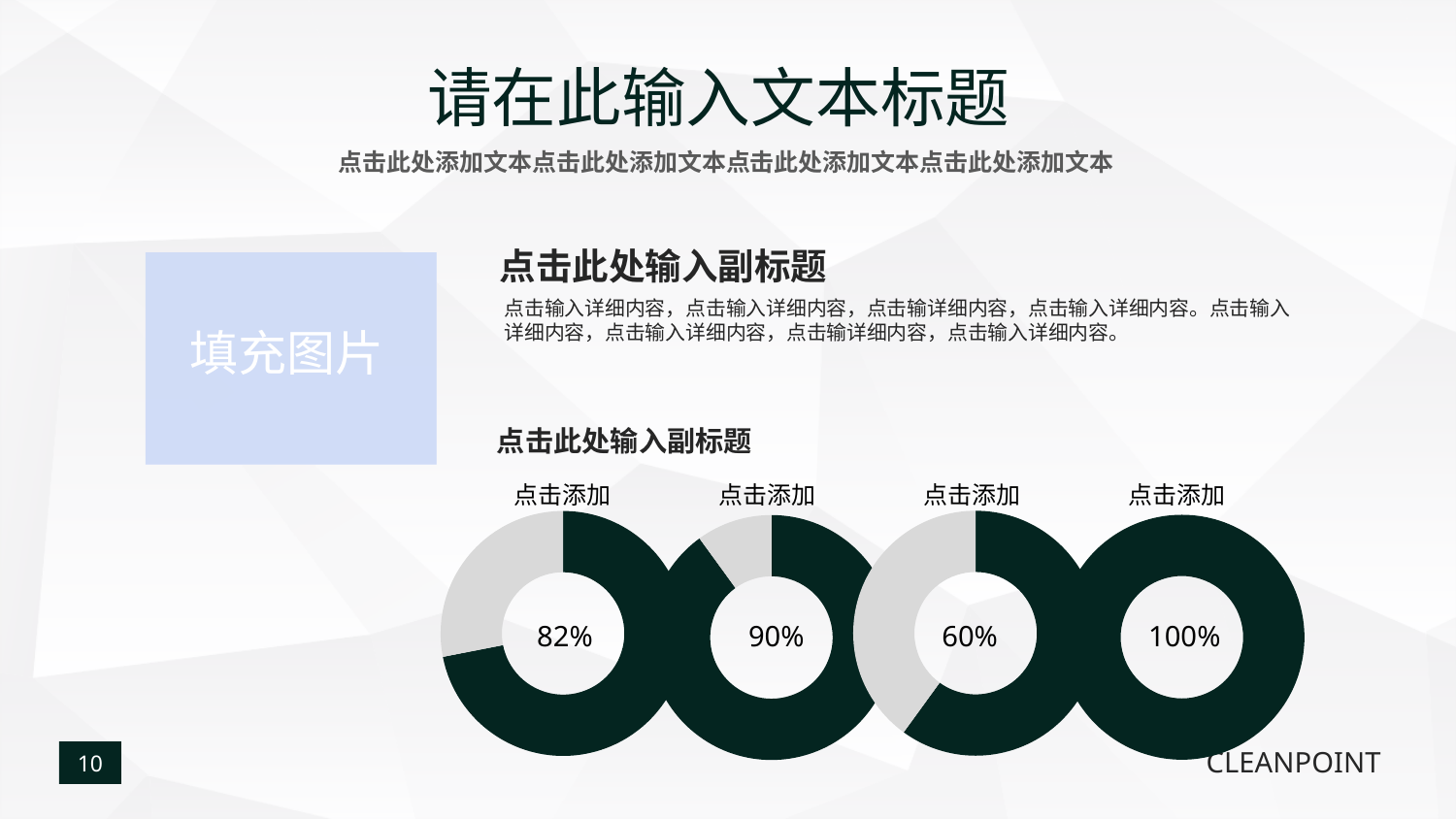
How many doughnut charts are shown on the slide? 4 What value is shown in the centre of the leftmost doughnut chart? 82% What label appears above each of the four doughnut charts? 点击添加 What type of chart is used to display the percentages on the slide? Doughnut chart Which of the four doughnut charts shows the highest percentage? The rightmost chart (100%) What value is shown in the centre of the third doughnut chart from the left? 60% What is the difference between the value in the second doughnut chart and the value in the leftmost doughnut chart? 8% What value is shown in the centre of the second doughnut chart from the left? 90% Which is larger: the value in the leftmost doughnut chart or the value in the third doughnut chart? The leftmost chart (82%) What value is shown in the centre of the rightmost doughnut chart? 100% Which of the four doughnut charts shows the lowest percentage? The third chart from the left (60%) What is the difference between the value in the rightmost doughnut chart and the value in the third doughnut chart? 40%